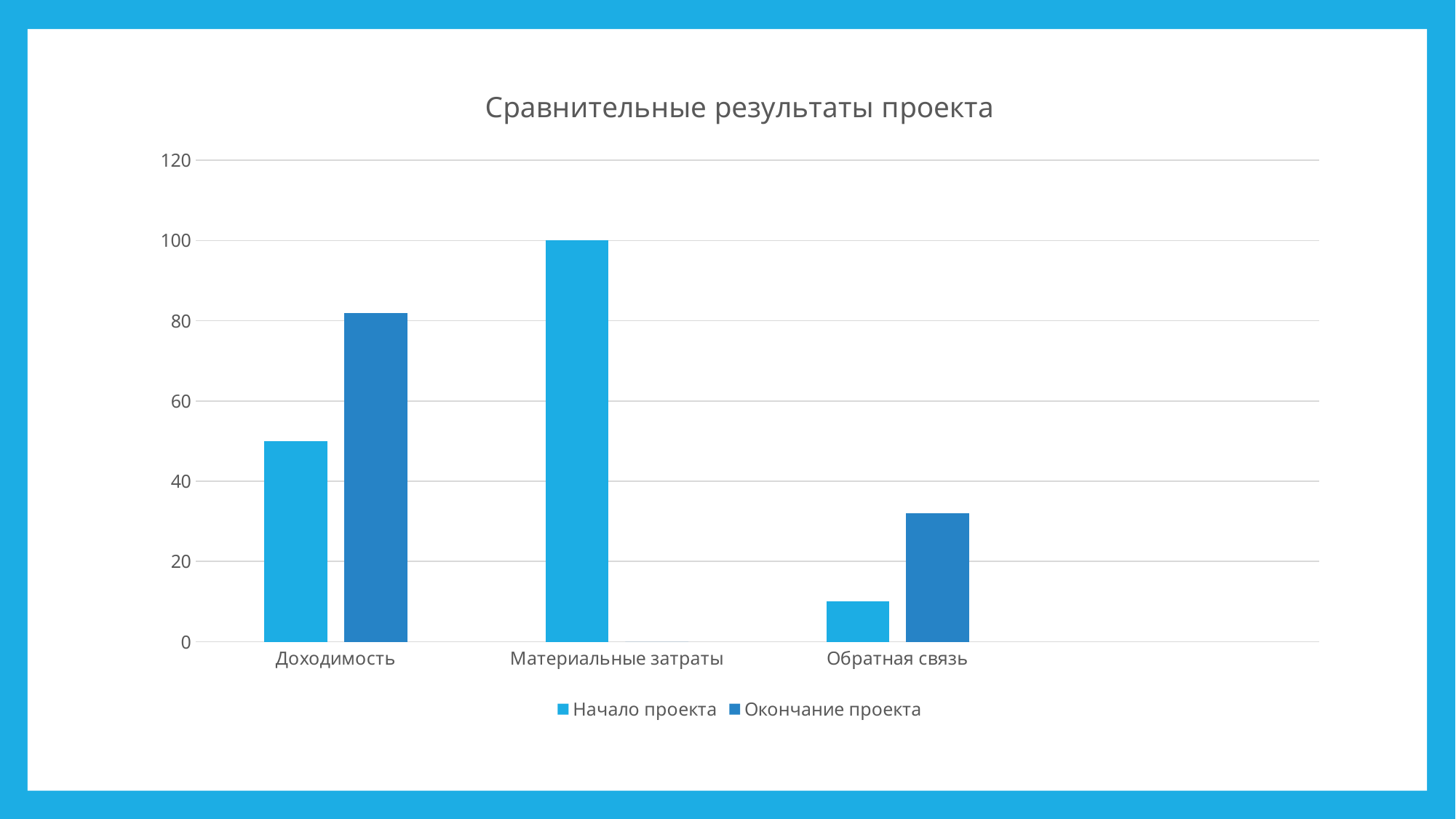
How many categories are shown on the x axis? 3 Is the value of Начало проекта for Обратная связь greater or less than 20? less For Доходимость, which is larger: Начало проекта or Окончание проекта? Окончание проекта Which category has the lowest Начало проекта value? Обратная связь What is the value of Начало проекта for Материальные затраты? 100 What kind of chart is shown on the slide? bar chart How many series does the legend list? 2 Is the value of Окончание проекта for Доходимость greater or less than 100? less Is the value of Начало проекта for Доходимость greater or less than 40? greater What is the title of the chart? Сравнительные результаты проекта Which category has the highest Начало проекта value? Материальные затраты